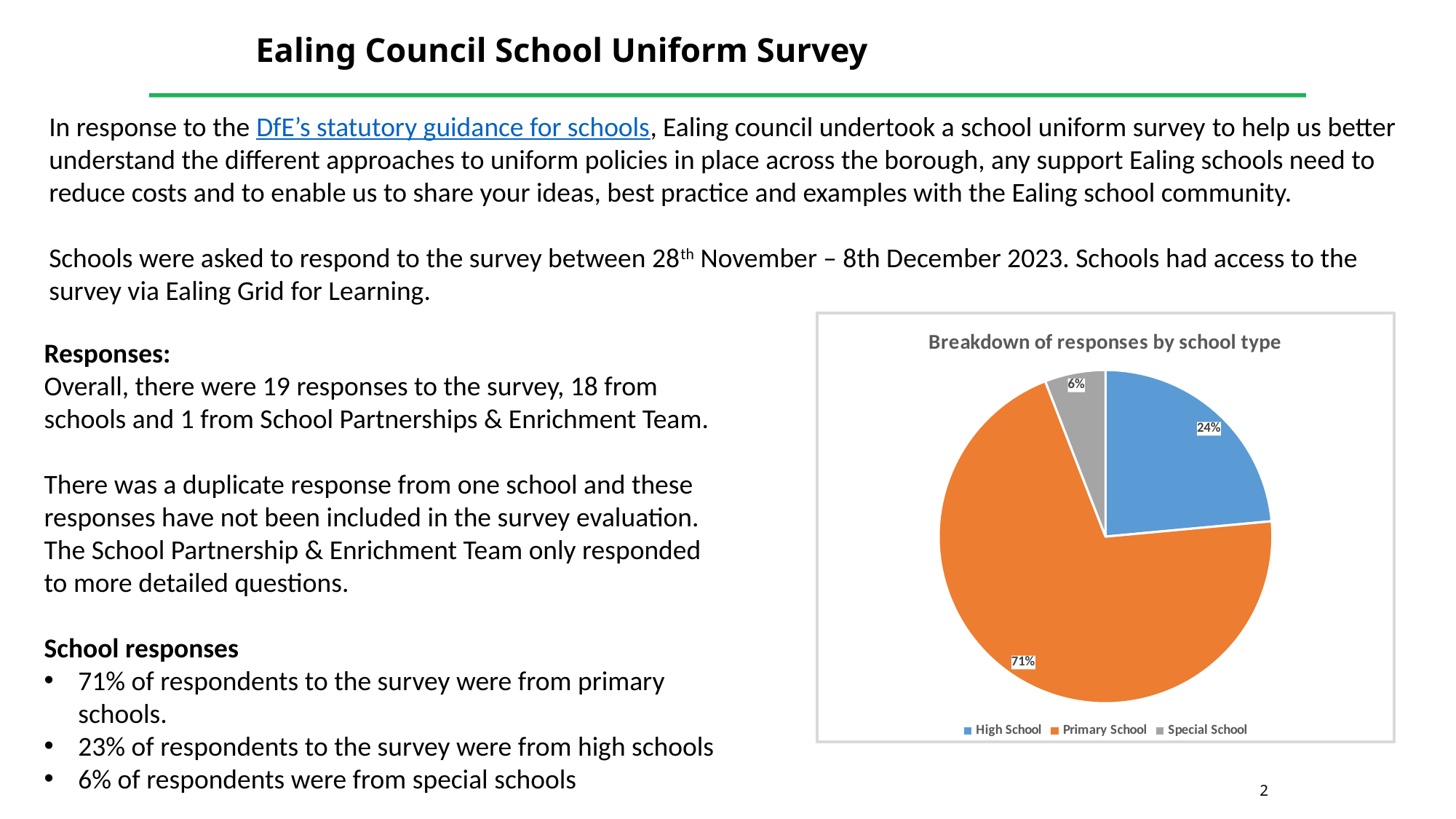
Which school type has the smallest slice in the pie chart? Special School What share of responses does the High School slice represent in the pie chart? 24% Which school type has the largest slice in the pie chart? Primary School What colour is the Primary School slice in the pie chart? Orange What kind of chart is shown on the slide? Pie chart What is the title of the chart? Breakdown of responses by school type What share of responses does the Primary School slice represent in the pie chart? 71% Which slice is larger, High School or Special School? High School How many school types are shown in the pie chart? 3 What share of responses does the Special School slice represent in the pie chart? 6% What is the difference in percentage points between the High School and Special School slices? 18 What is the difference in percentage points between the Primary School and High School slices? 47